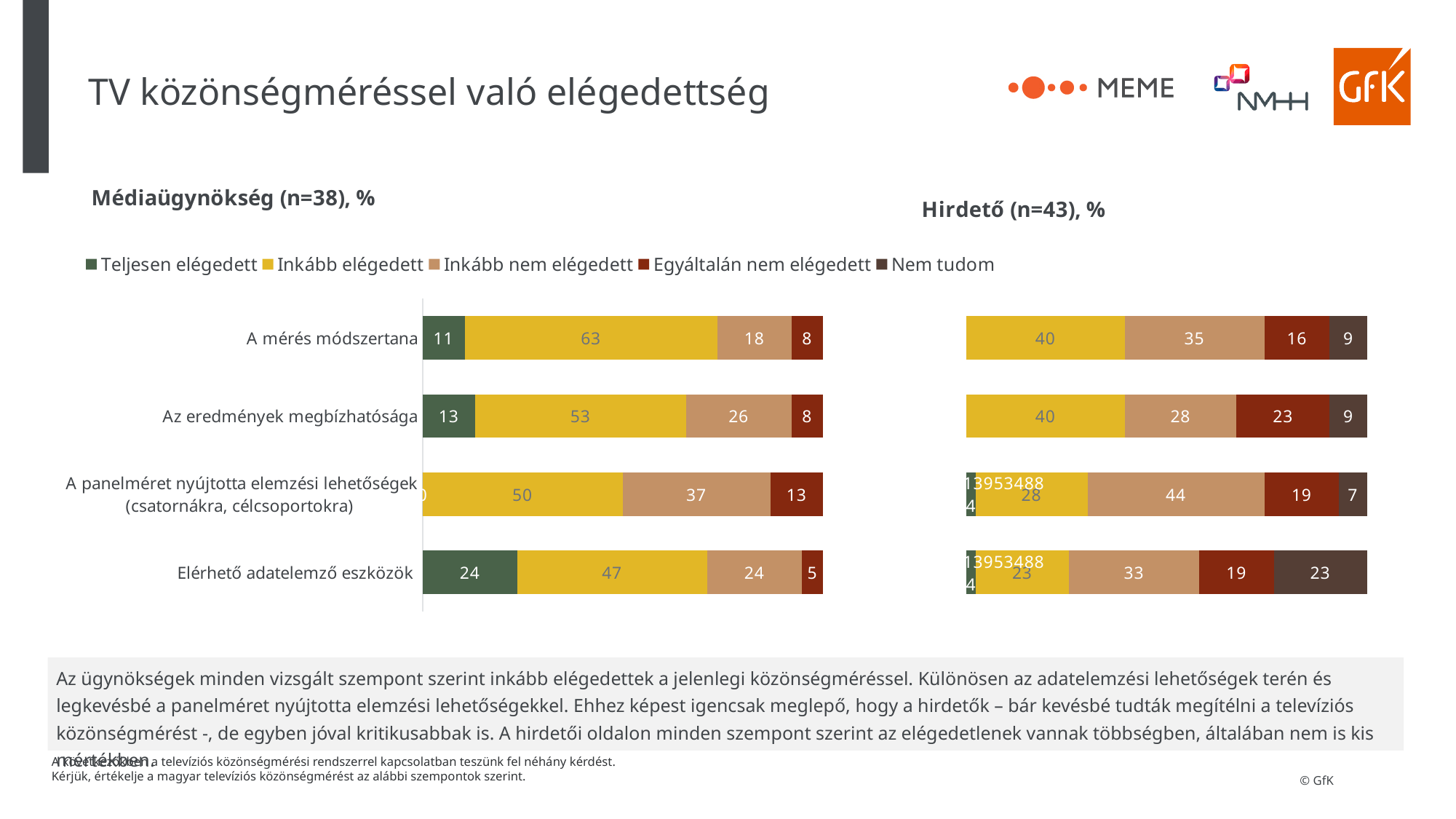
In the Médiaügynökség (n=38) chart, which category has the lowest Egyáltalán nem elégedett value? Elérhető adatelemző eszközök How many series does the legend list? 5 What kind of chart is the Hirdető (n=43) chart? Stacked bar chart How many categories are shown in the Médiaügynökség (n=38) chart? 4 In the Médiaügynökség (n=38) chart, what is the value for Inkább elégedett for 'A mérés módszertana'? 63 In the Médiaügynökség (n=38) chart, which category has the highest Teljesen elégedett value? Elérhető adatelemző eszközök In the Hirdető (n=43) chart, what is the difference between the Egyáltalán nem elégedett values for 'Az eredmények megbízhatósága' and 'A mérés módszertana'? 7 In the Hirdető (n=43) chart, what is the Nem tudom value for 'Elérhető adatelemző eszközök'? 23 In the Hirdető (n=43) chart, what is the Inkább nem elégedett value for 'A panelméret nyújtotta elemzési lehetőségek (csatornákra, célcsoportokra)'? 44 In the Médiaügynökség (n=38) chart, which is larger: the Inkább nem elégedett value for 'A panelméret nyújtotta elemzési lehetőségek' or for 'Az eredmények megbízhatósága'? A panelméret nyújtotta elemzési lehetőségek Which legend entry is shown in yellow? Inkább elégedett In the Médiaügynökség (n=38) chart, what is the Teljesen elégedett value for 'Elérhető adatelemző eszközök'? 24